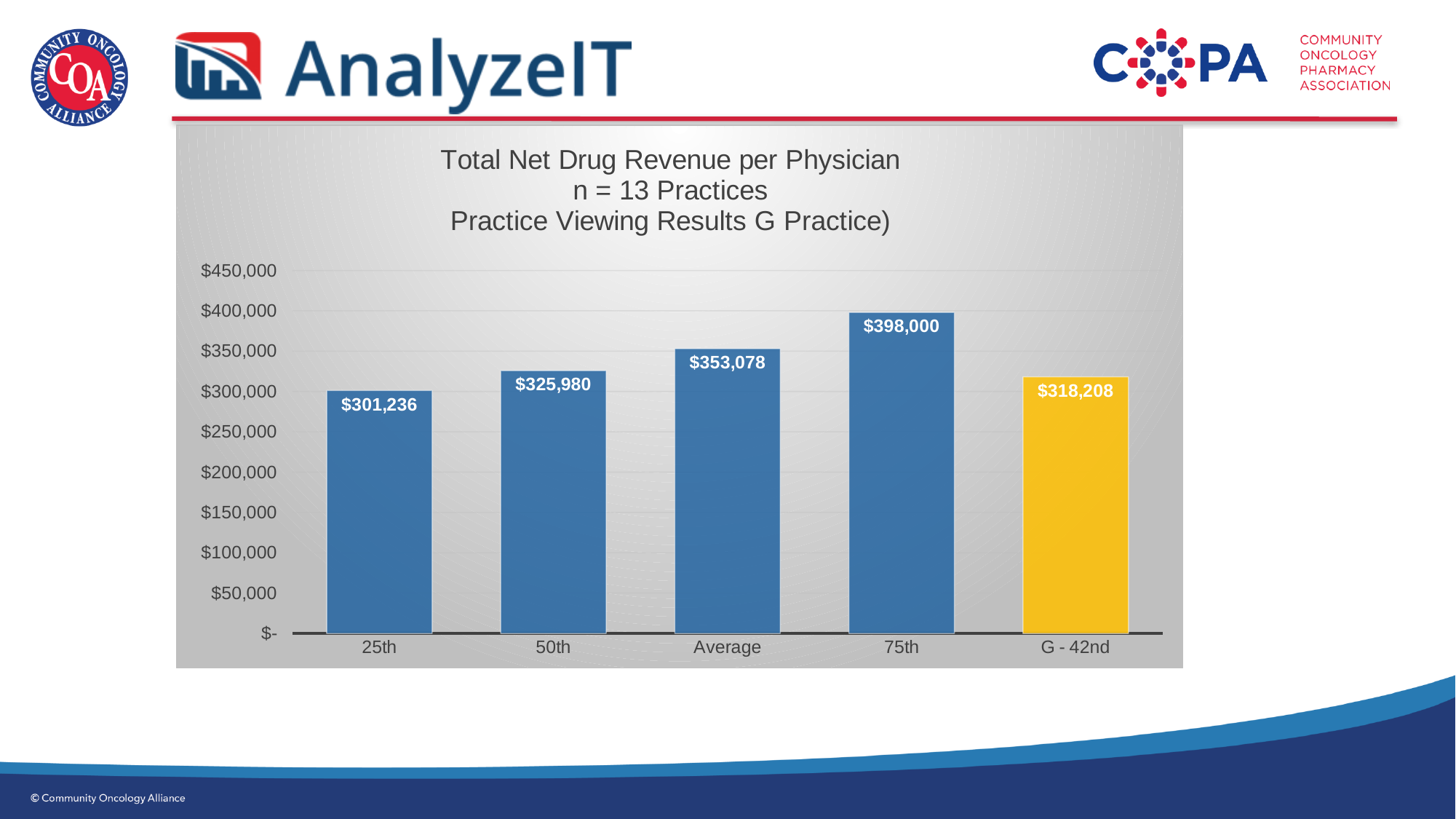
What is the difference between the 75th percentile value and the Average value? $44,922 What is the value for the 50th percentile bar? $325,980 What is the value for the G - 42nd bar? $318,208 Is the value for Average greater or less than $350,000? greater Which category has the lowest value? 25th What is the value for the Average bar? $353,078 What is the value for the 25th percentile bar? $301,236 How many bars are shown in the chart? 5 Which is larger, the value for 50th or the value for G - 42nd? 50th Which category has the highest value? 75th What is the difference between the G - 42nd value and the 25th percentile value? $16,972 What kind of chart is shown on the slide? Bar chart